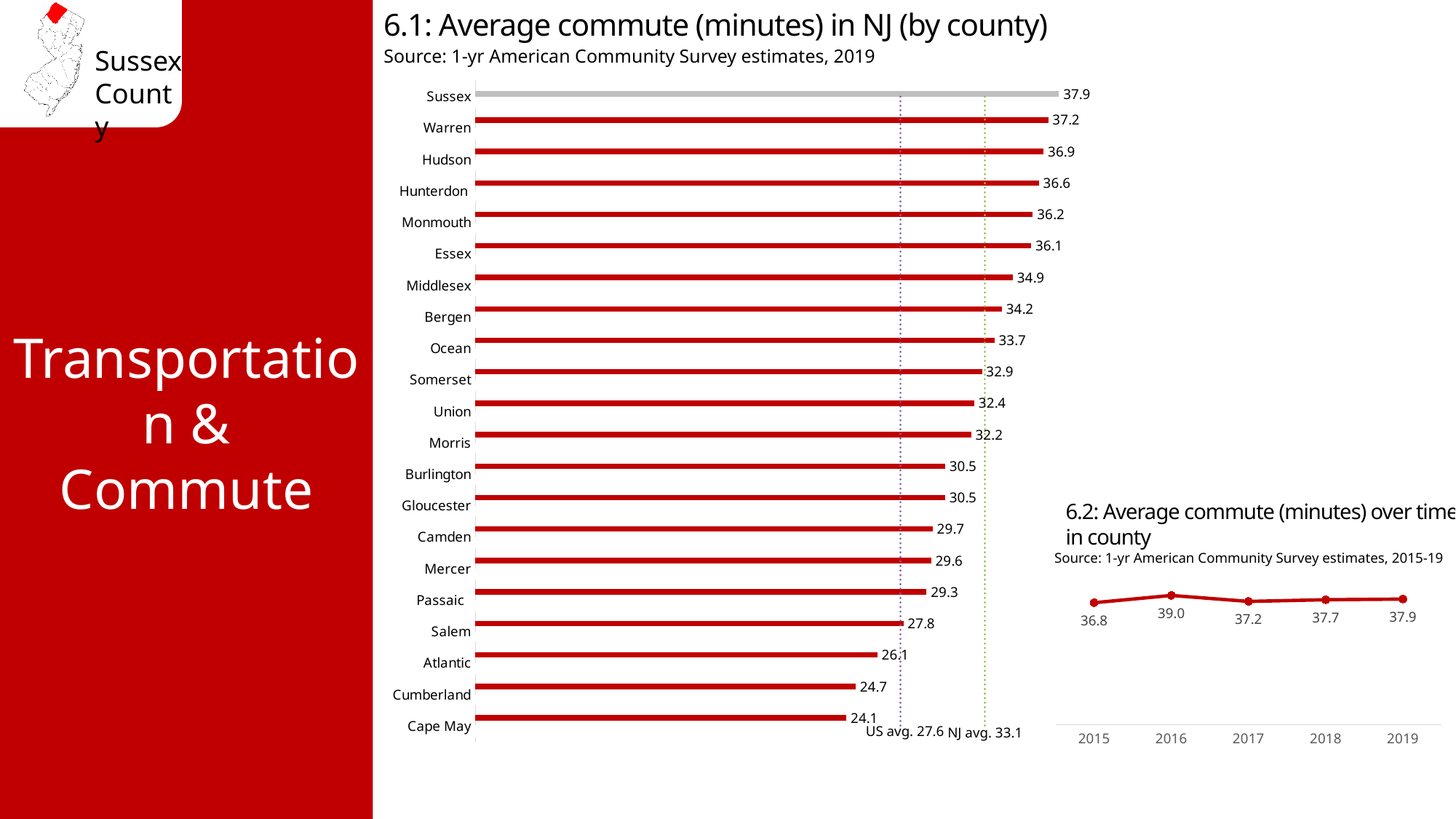
In chart 6.1 (Average commute in NJ by county), how many counties are shown? 21 In chart 6.2 (Average commute over time in county), what is the difference between 2016 and 2017? 1.8 In chart 6.1 (Average commute in NJ by county), what is the NJ average commute shown by the reference line? 33.1 In chart 6.1 (Average commute in NJ by county), what is the average commute for Hudson? 36.9 In chart 6.1 (Average commute in NJ by county), what is the difference between Sussex and Warren? 0.7 What kind of chart is chart 6.1 (Average commute in NJ by county)? Bar chart In chart 6.1 (Average commute in NJ by county), what is the average commute for Cape May? 24.1 In chart 6.2 (Average commute over time in county), what is the value for 2016? 39.0 In chart 6.1 (Average commute in NJ by county), which has a longer average commute, Bergen or Ocean? Bergen In chart 6.1 (Average commute in NJ by county), which county has the lowest average commute? Cape May In chart 6.2 (Average commute over time in county), which year has the lowest value? 2015 In chart 6.1 (Average commute in NJ by county), which county has the highest average commute? Sussex